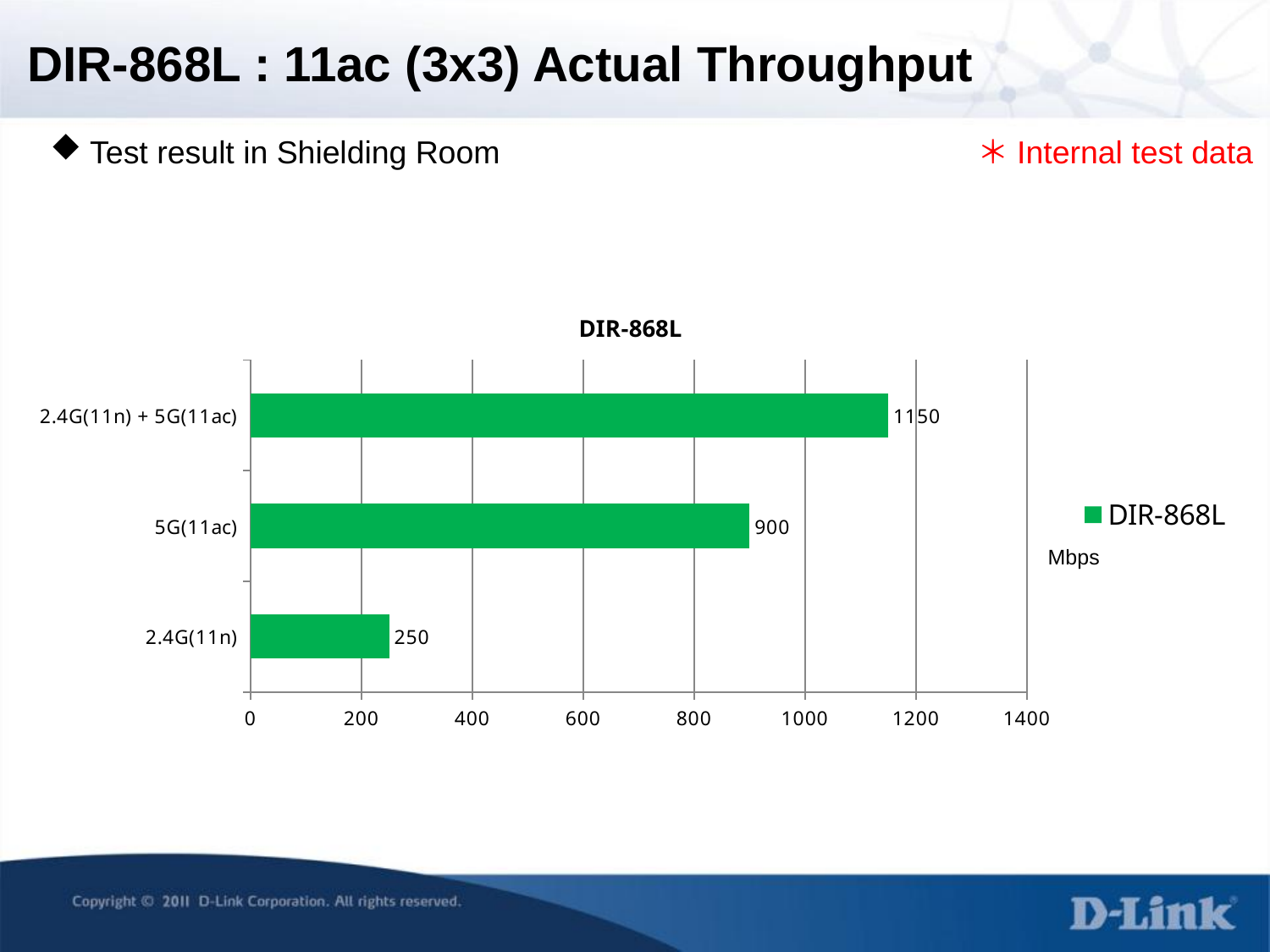
How many categories are shown in the chart? 3 Which is larger, the value for 5G(11ac) or the value for 2.4G(11n)? 5G(11ac) What is the difference between the values for 5G(11ac) and 2.4G(11n)? 650 What is the value for 2.4G(11n)? 250 Is the value for 5G(11ac) greater or less than 1000? less What is the value for 2.4G(11n) + 5G(11ac)? 1150 What is the difference between the values for 2.4G(11n) + 5G(11ac) and 5G(11ac)? 250 What kind of chart is shown on the slide? bar chart What is the title of the chart? DIR-868L Which category has the lowest value? 2.4G(11n) What is the value for 5G(11ac)? 900 Which category has the highest value? 2.4G(11n) + 5G(11ac)